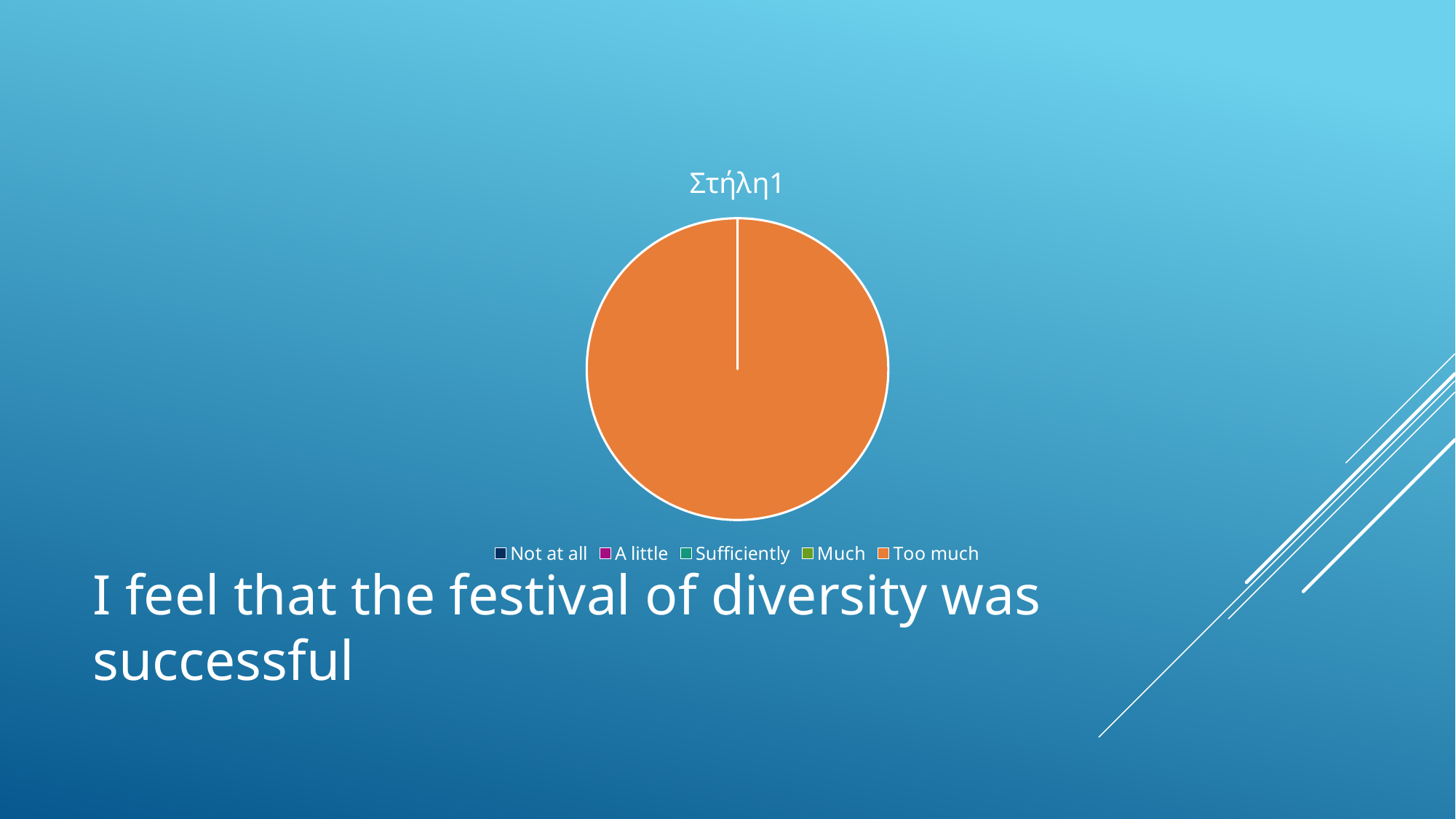
What is the title of the chart? Στήλη1 Which category accounts for the largest slice of the pie? Too much Which category is shown in orange in the legend? Too much What kind of chart is shown on the slide? pie chart Which of the two categories, 'Too much' or 'Much', has the larger share of the pie? Too much How many categories does the chart's legend list? 5 Which of the two categories, 'Too much' or 'Not at all', has the larger share of the pie? Too much